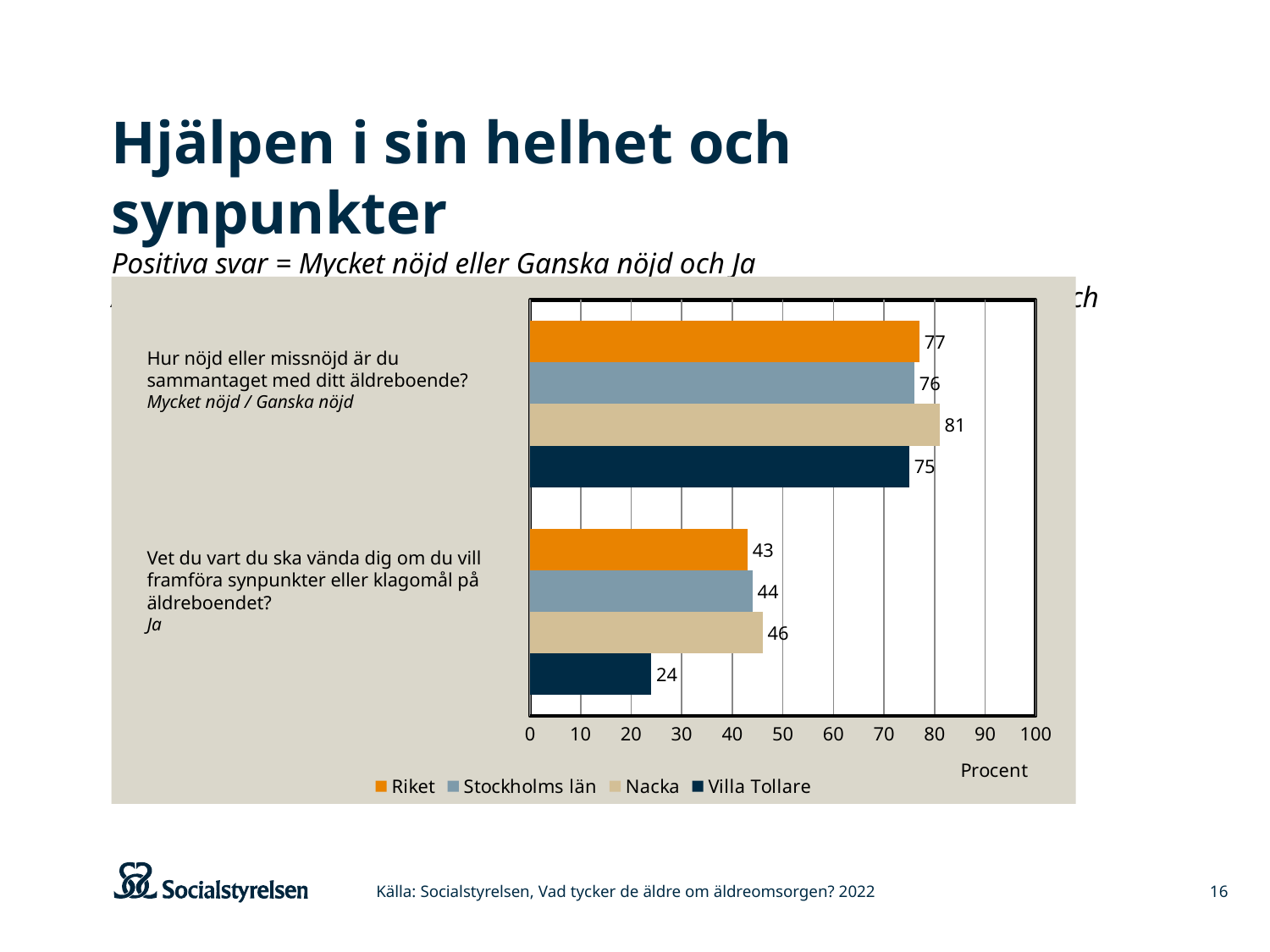
Which is larger for the question 'Hur nöjd eller missnöjd är du sammantaget med ditt äldreboende?': Riket or Stockholms län? Riket What value does Villa Tollare have for the question 'Vet du vart du ska vända dig om du vill framföra synpunkter eller klagomål på äldreboendet?' 24 What value does Nacka have for the question 'Hur nöjd eller missnöjd är du sammantaget med ditt äldreboende?' 81 Which series has the lowest value for the question 'Vet du vart du ska vända dig om du vill framföra synpunkter eller klagomål på äldreboendet?' Villa Tollare What kind of chart is shown on the slide? bar chart What is the label on the horizontal axis of the chart? Procent What is the difference between Nacka and Villa Tollare for the question 'Vet du vart du ska vända dig om du vill framföra synpunkter eller klagomål på äldreboendet?' 22 What value does Riket have for the question 'Vet du vart du ska vända dig om du vill framföra synpunkter eller klagomål på äldreboendet?' 43 Is the value for Villa Tollare on the question 'Vet du vart du ska vända dig om du vill framföra synpunkter eller klagomål på äldreboendet?' greater or less than 30? less How many series does the legend list? 4 What is the difference between Nacka and Villa Tollare for the question 'Hur nöjd eller missnöjd är du sammantaget med ditt äldreboende?' 6 Which series has the highest value for the question 'Hur nöjd eller missnöjd är du sammantaget med ditt äldreboende?' Nacka